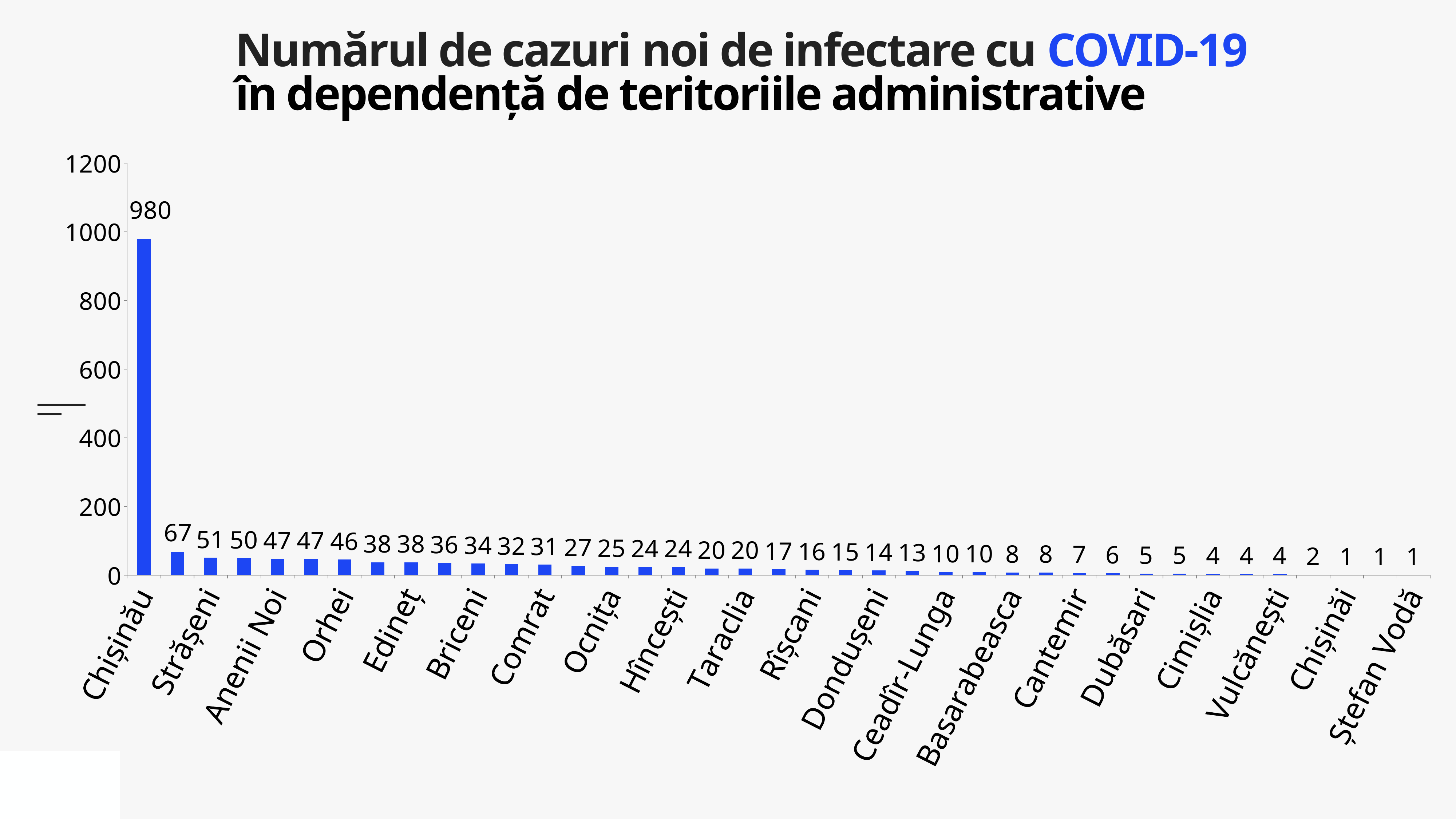
Is the value for Chișinău greater or less than 800? greater What is the value for Strășeni? 51 What is the value for Chișinău? 980 What is the value for Orhei? 46 What is the value of the second bar from the left? 67 Which is larger, the value for Chișinău or the value for Strășeni? Chișinău What kind of chart is shown? bar chart Which category has the highest value? Chișinău What is the highest tick value on the vertical axis? 1200 What is the value of the tallest bar? 980 Do the values rise or fall from left to right along the x axis? fall What is the smallest value shown on any bar? 1